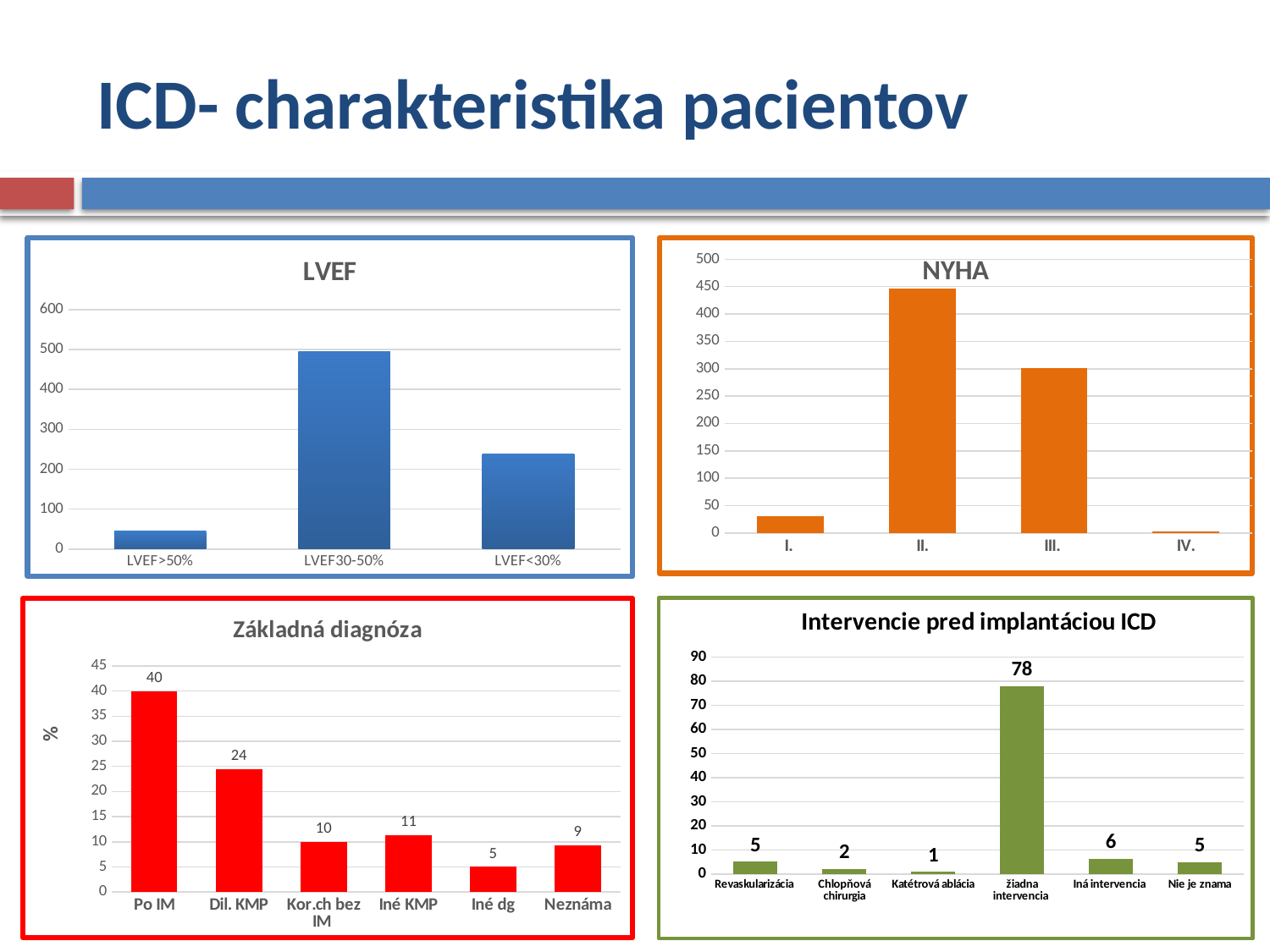
In the 'NYHA' chart, which category has the highest value? II. In the 'Intervencie pred implantáciou ICD' chart, which category has the lowest value? Katétrová ablácia In the 'Intervencie pred implantáciou ICD' chart, how many categories are shown on the x axis? 6 In the 'LVEF' chart, which category has the highest value? LVEF30-50% In the 'LVEF' chart, is the value for LVEF<30% greater or less than 200? greater In the 'Základná diagnóza' chart, what is the value for Po IM? 40 In the 'NYHA' chart, is the value for III. greater or less than 250? greater In the 'Intervencie pred implantáciou ICD' chart, what is the difference between the values for Iná intervencia and Chlopňová chirurgia? 4 In the 'Základná diagnóza' chart, what is the difference between the values for Po IM and Dil. KMP? 16 In the 'Intervencie pred implantáciou ICD' chart, what is the value for žiadna intervencia? 78 In the 'Základná diagnóza' chart, which category has the lowest value? Iné dg In the 'Základná diagnóza' chart, what is the value for Dil. KMP? 24